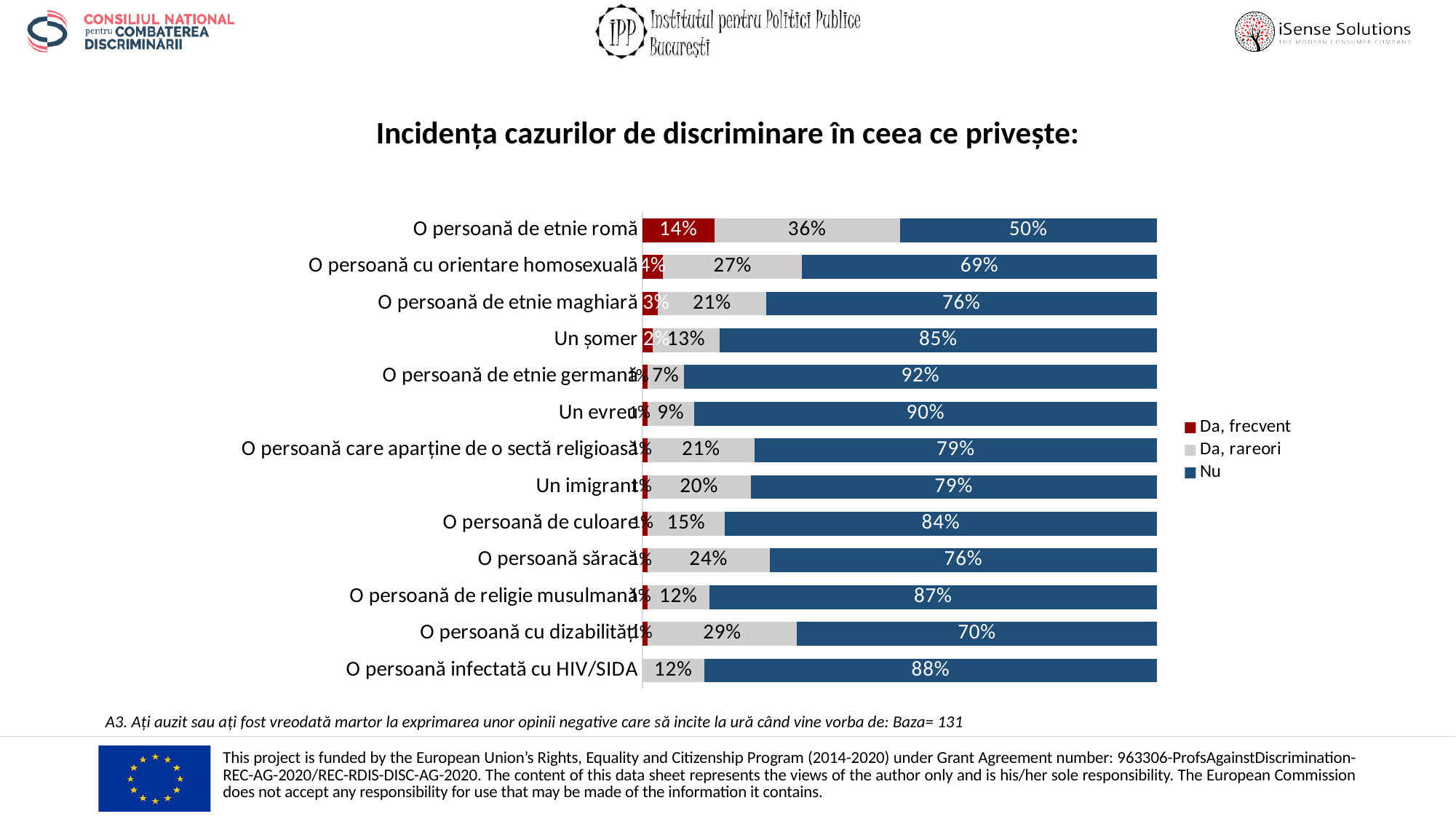
What is the "Nu" value for "O persoană infectată cu HIV/SIDA"? 88% What is the "Nu" value for "O persoană de etnie romă"? 50% Which category has the highest "Da, rareori" value? O persoană de etnie romă What is the difference between the "Nu" values for "O persoană cu orientare homosexuală" and "O persoană de etnie romă"? 19 percentage points Which category has the highest "Nu" value? O persoană de etnie germană What kind of chart is shown on the slide? Stacked bar chart What is the "Da, frecvent" value for "O persoană de etnie romă"? 14% How many categories are shown in the chart? 13 What is the "Da, rareori" value for "O persoană cu dizabilități"? 29% Which category has the lowest "Nu" value? O persoană de etnie romă How many series does the legend list? 3 Which has a larger "Da, rareori" value: "O persoană săracă" or "Un șomer"? O persoană săracă